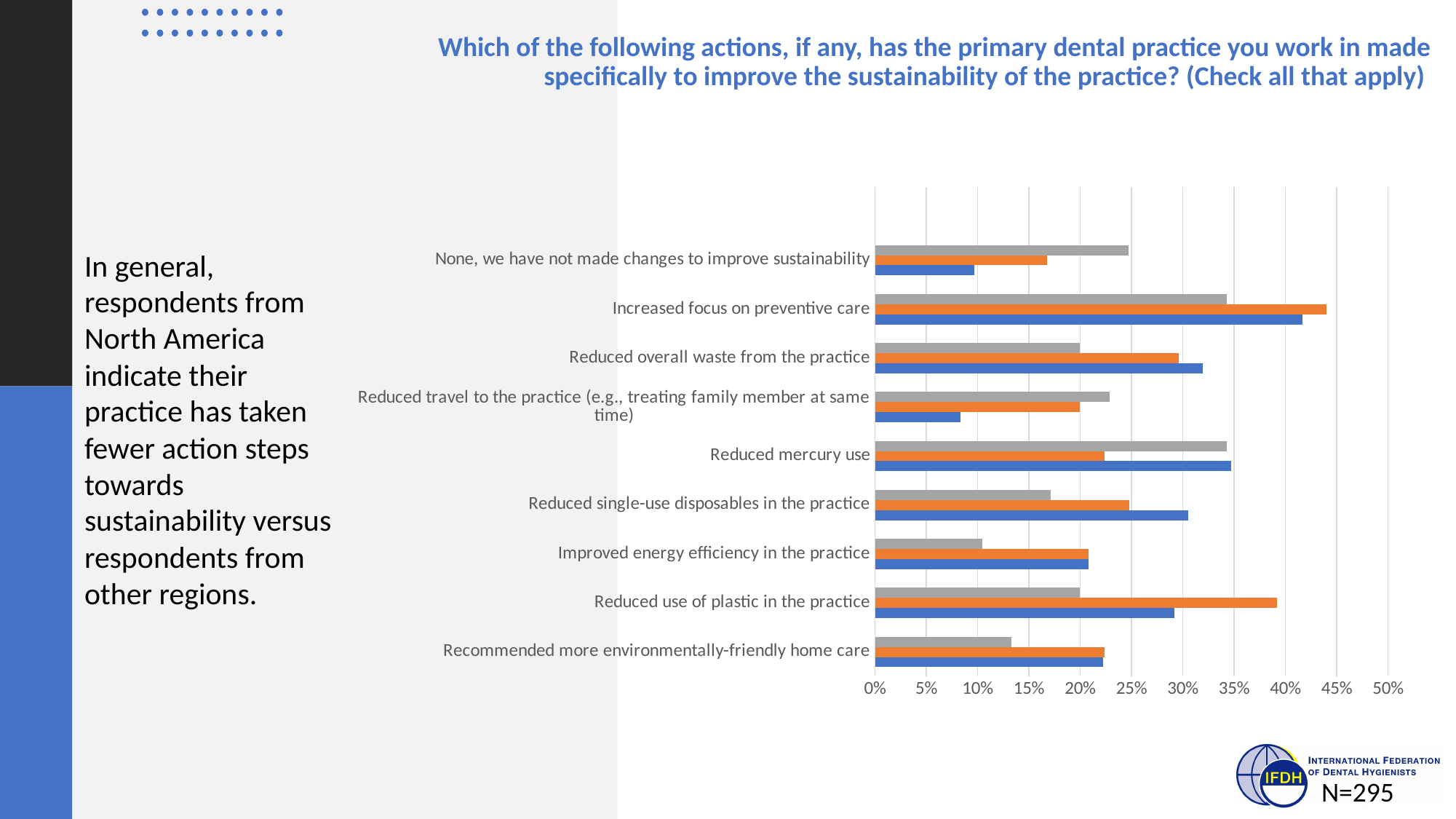
Is the blue bar for 'Reduced travel to the practice (e.g., treating family member at same time)' greater or less than 10%? less For 'Reduced use of plastic in the practice', which bar is longer, the blue one or the orange one? orange How many action categories are listed on the chart? 9 For 'Reduced travel to the practice (e.g., treating family member at same time)', which bar is longer, the blue one or the gray one? gray What sample size (N) is shown on the slide? N=295 Which category has the longest orange bar? Increased focus on preventive care Is the orange bar for 'Reduced use of plastic in the practice' greater or less than 35%? greater Which category has the longest blue bar? Increased focus on preventive care What kind of chart is shown on the slide? bar chart Is the gray bar for 'Improved energy efficiency in the practice' greater or less than 15%? less Which category has the shortest orange bar? None, we have not made changes to improve sustainability